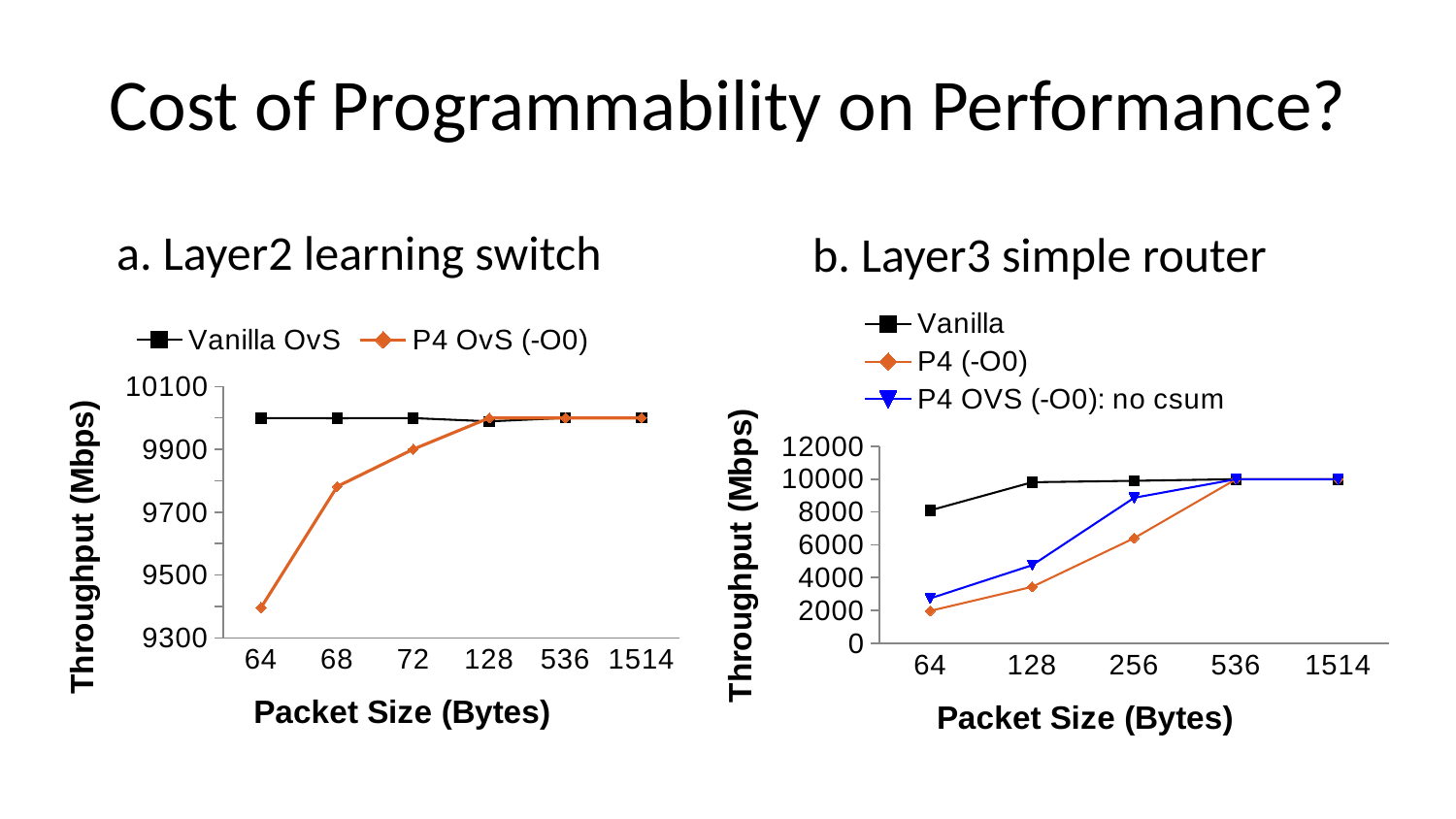
How many packet sizes are plotted on the x axis of the Layer2 learning switch chart? 6 In the Layer2 learning switch chart, is the throughput of P4 OvS (-O0) at packet size 64 greater or less than 9500? less In the Layer3 simple router chart, which series has the lowest throughput at packet size 128? P4 (-O0) In the Layer2 learning switch chart, is the throughput of Vanilla OvS at packet size 64 greater or less than 9900? greater In the Layer3 simple router chart, which has higher throughput at packet size 64: Vanilla or P4 (-O0)? Vanilla How many series does the legend of the Layer3 simple router chart list? 3 In the Layer3 simple router chart, is the throughput of P4 (-O0) at packet size 64 greater or less than 4000? less What is the x-axis title of the Layer3 simple router chart? Packet Size (Bytes) How many packet sizes are plotted on the x axis of the Layer3 simple router chart? 5 What kind of chart is the Layer2 learning switch chart? line chart How many series does the legend of the Layer2 learning switch chart list? 2 In the Layer2 learning switch chart, does the P4 OvS (-O0) throughput rise or fall as packet size increases? rise